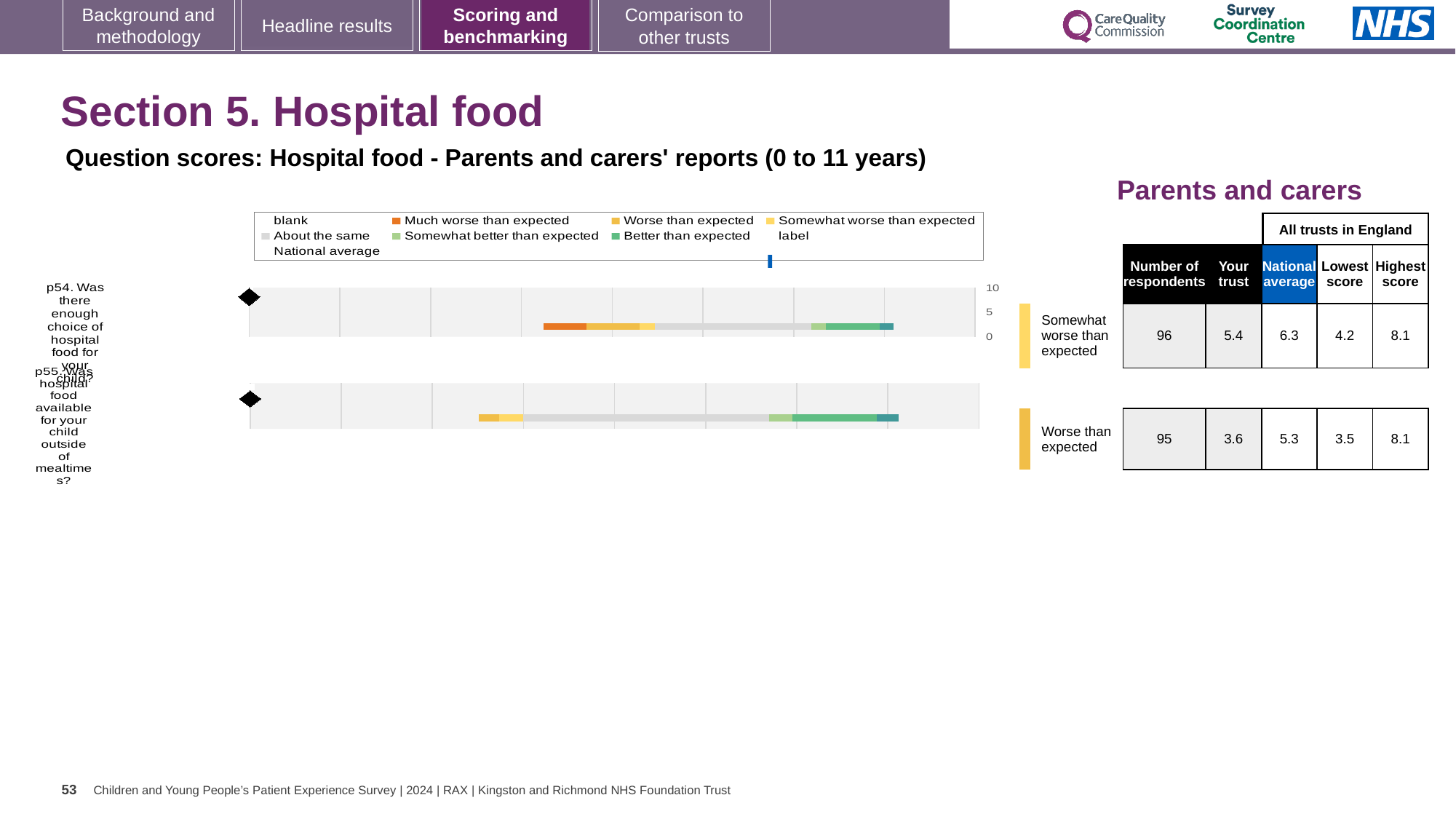
What is the lowest score across all trusts in England for p55? 3.5 What is the 'Your trust' score for p54 (enough choice of hospital food) in the table? 5.4 Which legend entry is shown in orange? Much worse than expected What kind of chart is shown on the slide? bar chart Which legend entry is shown in light grey? About the same What benchmark category is p55 rated as? Worse than expected What is the difference between the national average and the trust's score for p55? 1.7 What is the difference between the national average and the trust's score for p54? 0.9 Which question has the higher 'Your trust' score, p54 or p55? p54 How many questions (categories) are plotted in the chart? 2 What is the national average score for p55 (hospital food available outside of mealtimes)? 5.3 How many respondents answered p54? 96